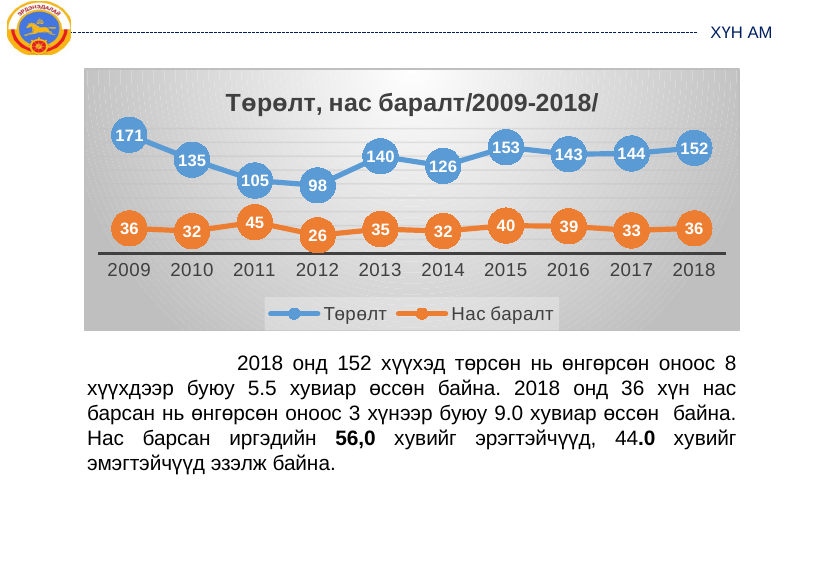
In which year is Төрөлт lowest? 2012 In which year is Төрөлт highest? 2009 What is the title of the chart? Төрөлт, нас баралт/2009-2018/ What is the value of Төрөлт in 2018? 152 What is the value of Нас баралт in 2011? 45 What is the difference between Төрөлт in 2018 and Төрөлт in 2017? 8 In which year is Нас баралт lowest? 2012 What kind of chart is this? line chart Which is larger: Нас баралт in 2015 or Нас баралт in 2016? 2015 How many years are shown on the x axis? 10 What is the value of Төрөлт in 2009? 171 How many series does the legend list? 2